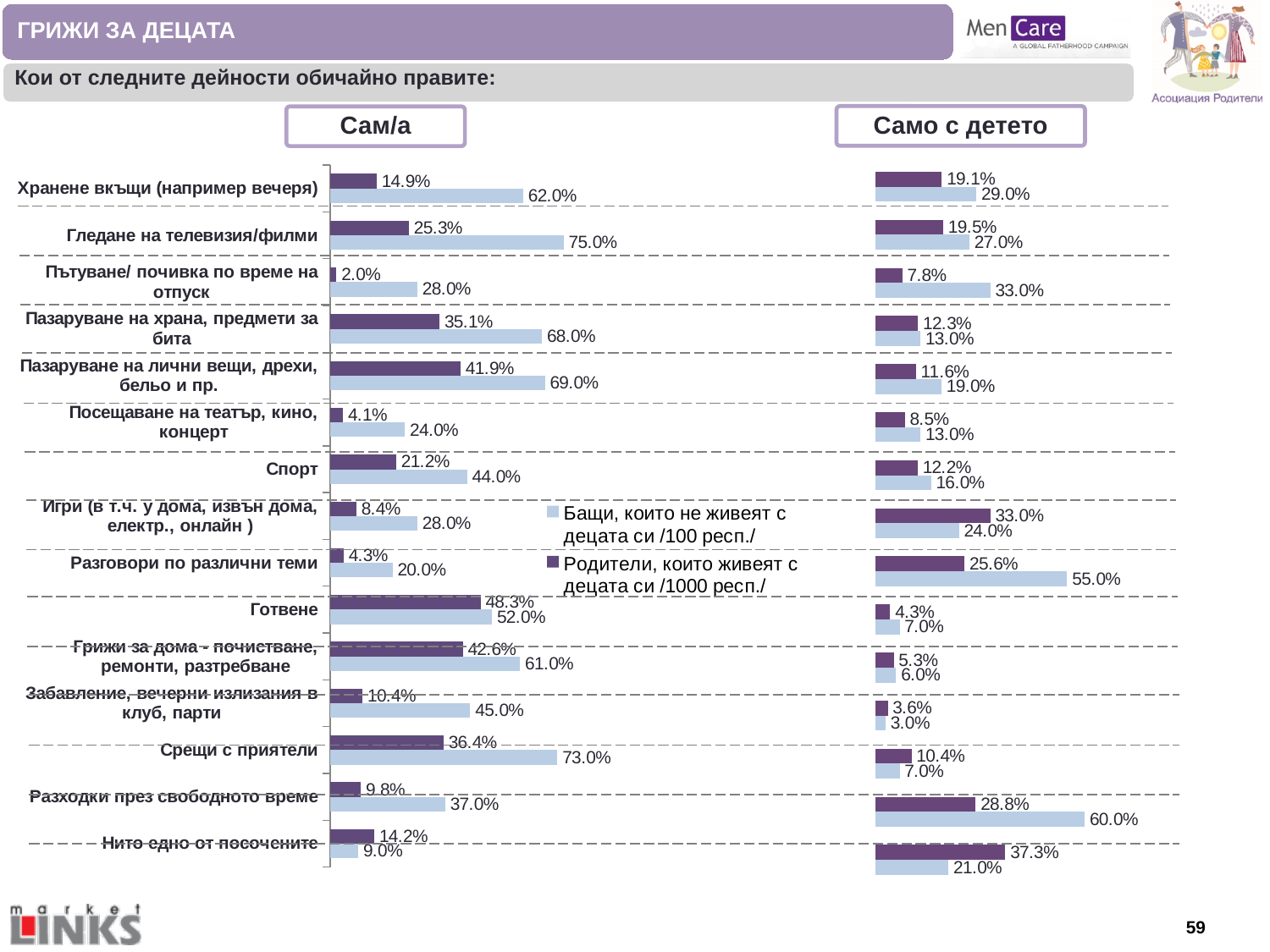
Which colour represents the series 'Бащи, които не живеят с децата си /100 респ./' in the legend? Light blue In the 'Сам/а' chart, which category has the lowest value for the series 'Родители, които живеят с децата си /1000 респ./'? Пътуване/ почивка по време на отпуск In the 'Сам/а' chart, what is the value for 'Гледане на телевизия/филми' for the series 'Бащи, които не живеят с децата си /100 респ./'? 75.0% In the 'Сам/а' chart, what is the difference between the two series' values for 'Хранене вкъщи (например вечеря)'? 47.1% What type of chart is the 'Само с детето' chart? Bar chart How many categories are shown in the 'Сам/а' chart? 15 In the 'Сам/а' chart, which category has the highest value for the series 'Родители, които живеят с децата си /1000 респ./'? Готвене In the 'Само с детето' chart, what is the value for 'Разговори по различни теми' for the series 'Родители, които живеят с децата си /1000 респ./'? 25.6% In the 'Само с детето' chart, which category has the highest value for the series 'Бащи, които не живеят с децата си /100 респ./'? Разходки през свободното време In the 'Само с детето' chart, which series has the larger value for 'Игри (в т.ч. у дома, извън дома, електр., онлайн )'? Родители, които живеят с децата си /1000 респ./ In the 'Само с детето' chart, what is the difference between the two series' values for 'Нито едно от посочените'? 16.3% How many series does the legend list? 2